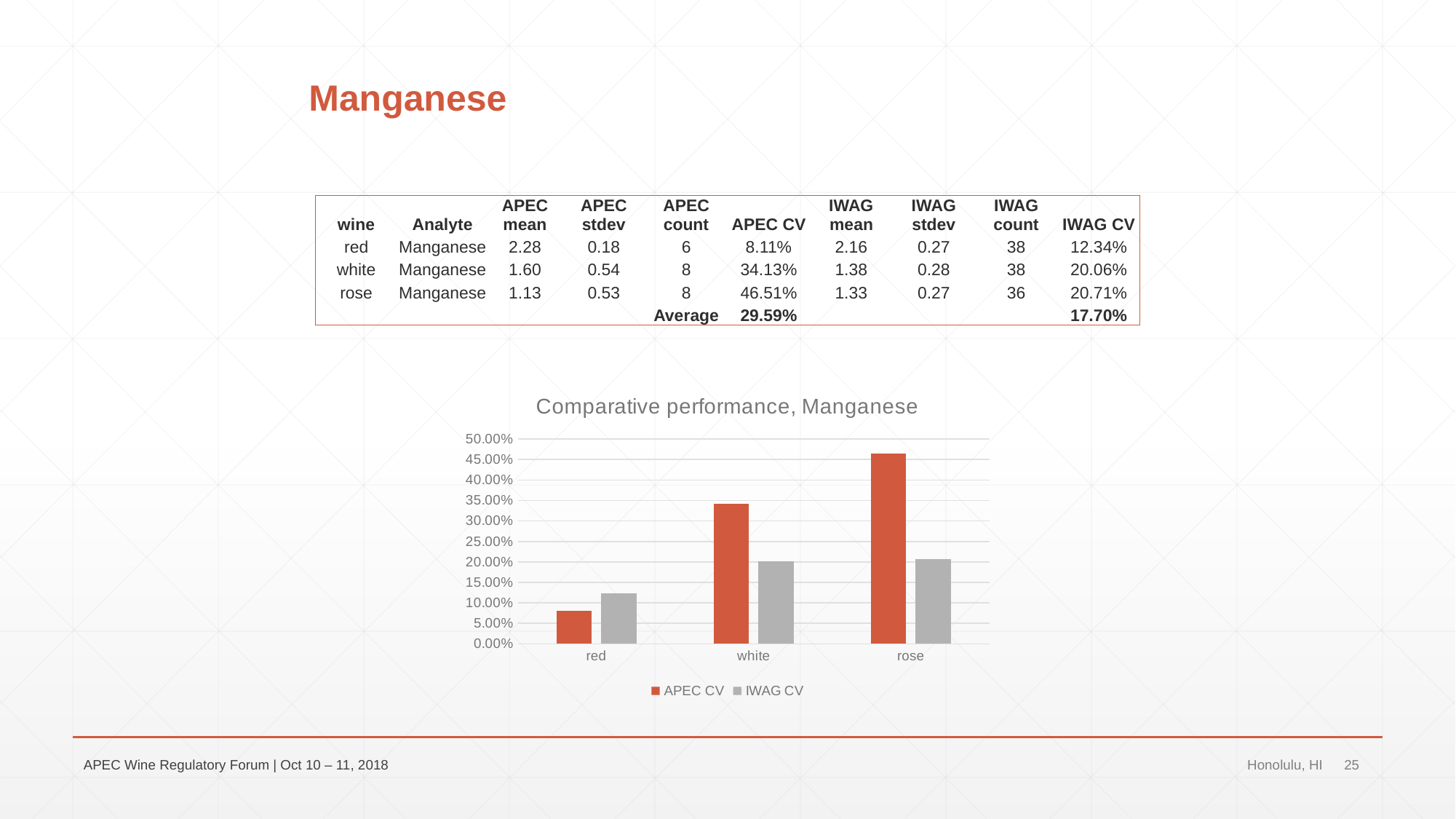
Which wine category has the highest APEC CV bar? rose For red wine, which is larger, the APEC CV or the IWAG CV? IWAG CV What is the title of the chart? Comparative performance, Manganese Which wine category has the lowest APEC CV bar? red Is the APEC CV value for rose greater or less than 40.00%? greater How many wine categories are shown on the x axis of the chart? 3 What kind of chart is shown on the slide? bar chart Which wine category has the lowest IWAG CV bar? red Do the APEC CV bars rise or fall moving from red to white to rose along the x axis? rise How many series does the chart legend list? 2 Is the IWAG CV value for white greater or less than 25.00%? less For white wine, which is larger, the APEC CV or the IWAG CV? APEC CV